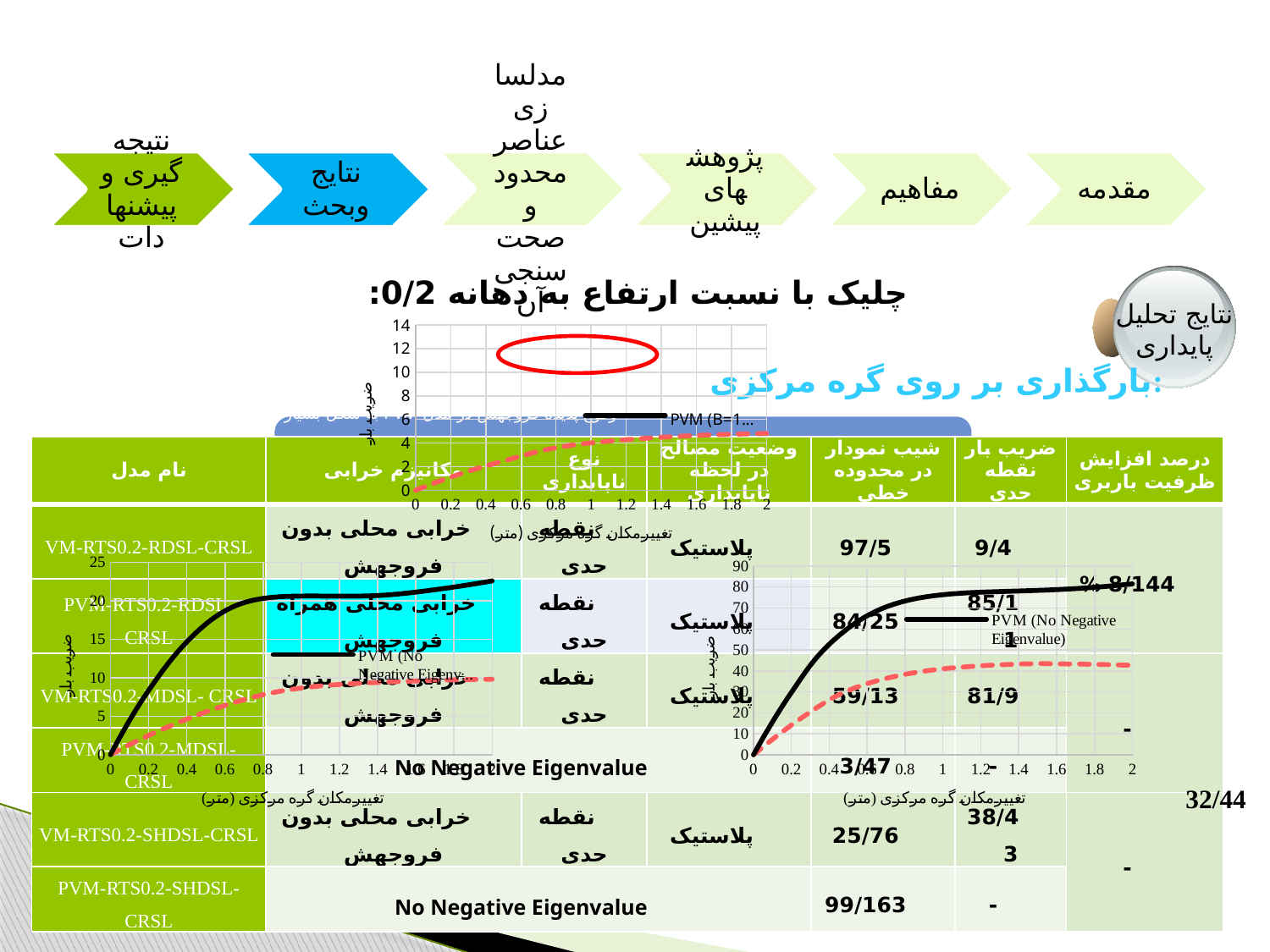
In the bottom-left chart, is the value of the black solid line at x = 1.4 greater or less than 15? greater What is the highest tick value on the y axis of the bottom-left chart? 25 In the bottom-right chart, is the value of the red dashed line at x = 2 greater or less than 60? less In the bottom-right chart, does the black solid line rise or fall as the x value increases? rises What is the highest tick value on the y axis of the top chart (the one with the red oval)? 14 In the bottom-right chart, is the value of the black solid line at x = 2 greater or less than 50? greater In the bottom-left chart, does the red dashed line rise or fall as the x value increases? rises What is the highest tick value on the y axis of the bottom-right chart? 90 What kind of chart is the bottom-right chart on the slide? line chart How many lines are plotted in the bottom-right chart? 2 What is the largest tick value on the x axis of the bottom-right chart? 2